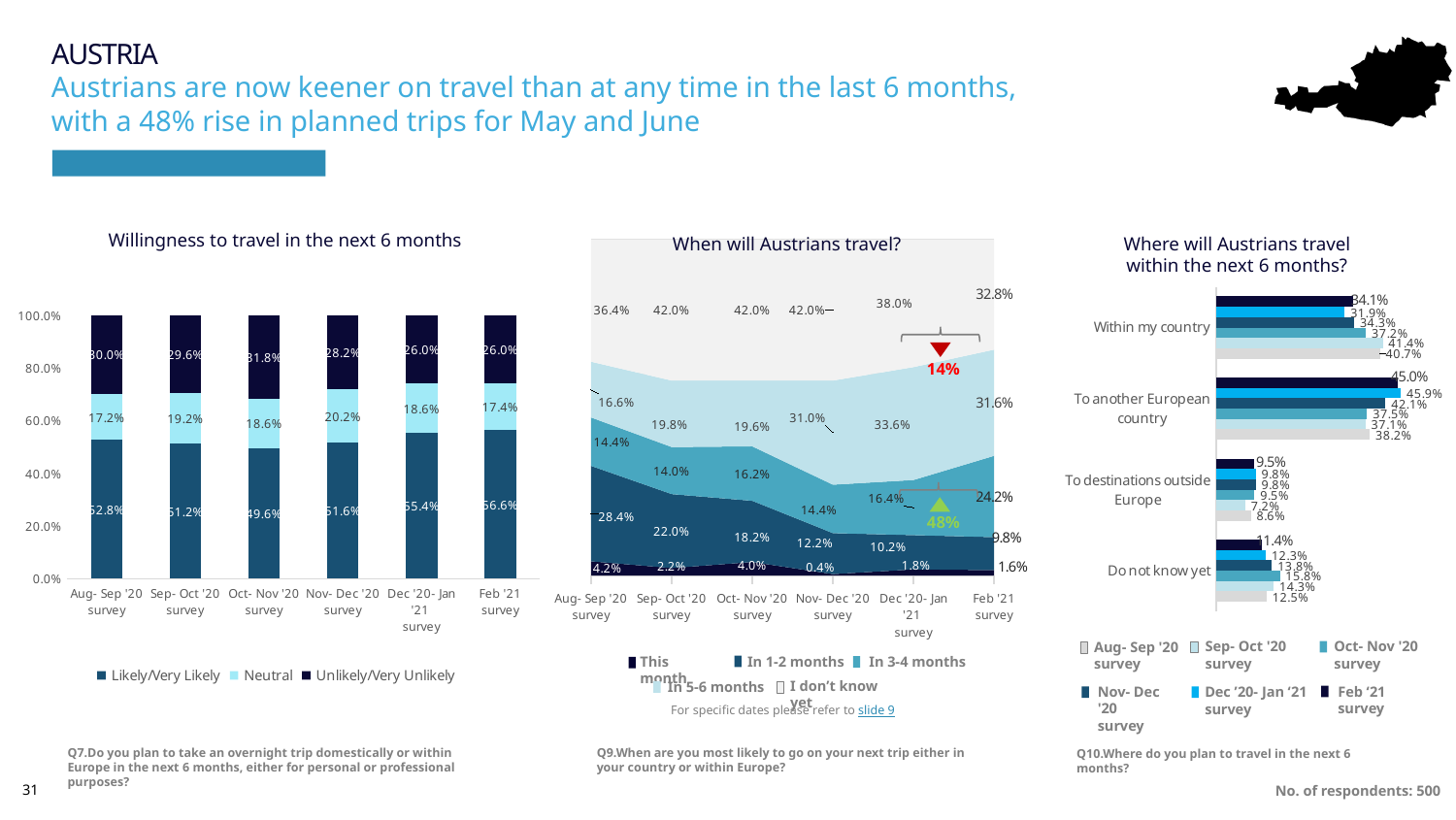
In the 'Willingness to travel in the next 6 months' chart, which survey has the lowest Likely/Very Likely value? Oct- Nov '20 survey What kind of chart is 'Where will Austrians travel within the next 6 months?'? bar chart In the 'Where will Austrians travel within the next 6 months?' chart, which survey has the highest value for 'Within my country'? Sep- Oct '20 survey In the 'Willingness to travel in the next 6 months' chart, how many surveys are shown on the x axis? 6 In the 'Where will Austrians travel within the next 6 months?' chart, what is the Feb '21 survey value for 'To another European country'? 45.0% In the 'When will Austrians travel?' chart, what is the 'In 3-4 months' value for the Feb '21 survey? 24.2% In the 'When will Austrians travel?' chart, does the 'In 1-2 months' value rise or fall from the Aug- Sep '20 survey to the Feb '21 survey? fall In the 'When will Austrians travel?' chart, which is larger for the Dec '20- Jan '21 survey: 'In 5-6 months' or 'I don't know yet'? I don't know yet In the 'Willingness to travel in the next 6 months' chart, how many series does the legend list? 3 In the 'Willingness to travel in the next 6 months' chart, what is the Likely/Very Likely value for the Feb '21 survey? 56.6% In the 'When will Austrians travel?' chart, what is the 'This month' value for the Nov- Dec '20 survey? 0.4% In the 'Willingness to travel in the next 6 months' chart, what is the difference between the Neutral values for the Nov- Dec '20 survey and the Aug- Sep '20 survey? 3.0%